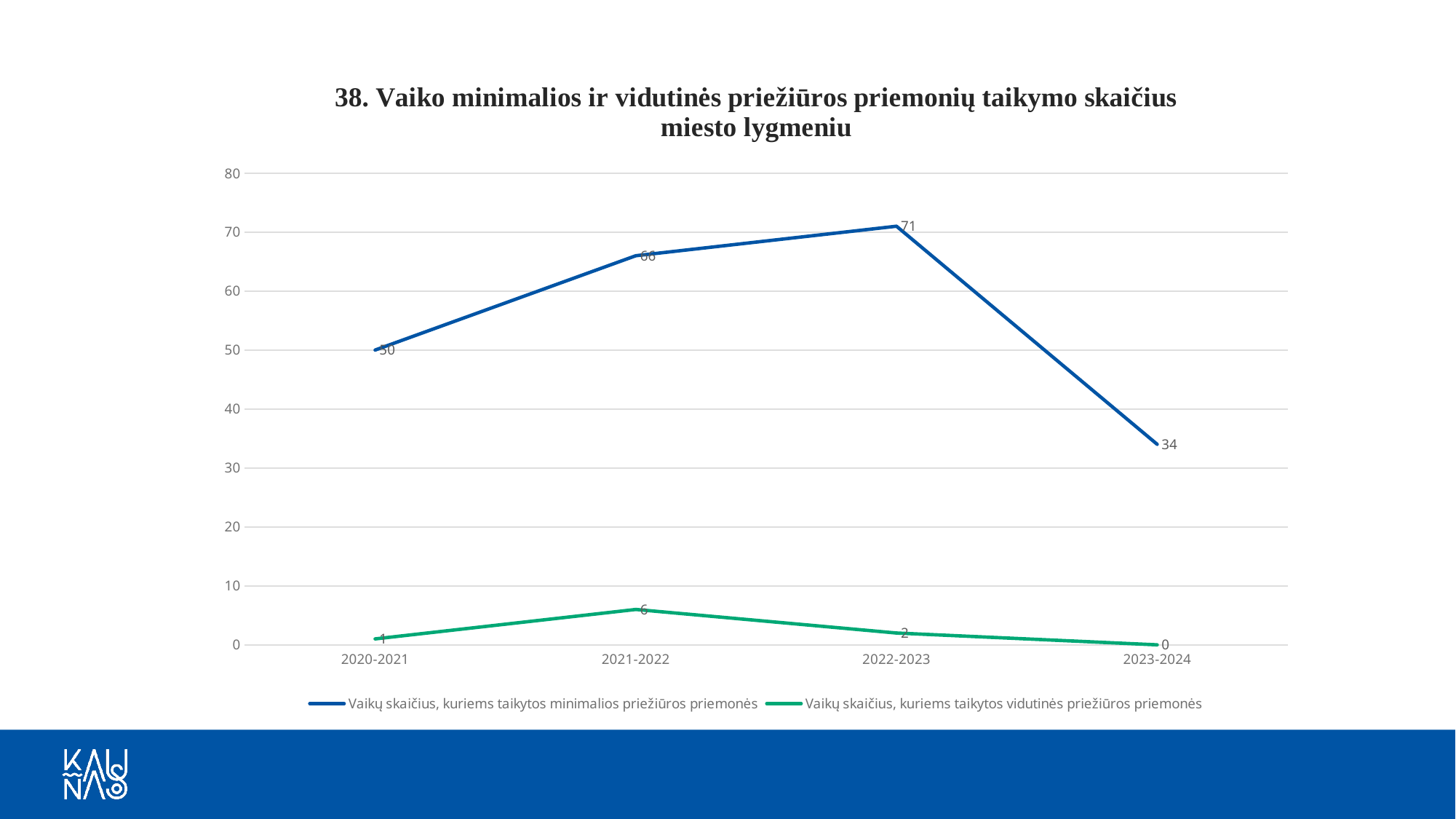
What type of chart is shown on the slide? line chart What is the value for 'Vaikų skaičius, kuriems taikytos minimalios priežiūros priemonės' in 2023-2024? 34 What is the value for 'Vaikų skaičius, kuriems taikytos vidutinės priežiūros priemonės' in 2023-2024? 0 Does the value for 'Vaikų skaičius, kuriems taikytos minimalios priežiūros priemonės' rise or fall from 2022-2023 to 2023-2024? fall In which period is the value for 'Vaikų skaičius, kuriems taikytos minimalios priežiūros priemonės' highest? 2022-2023 What is the value for 'Vaikų skaičius, kuriems taikytos minimalios priežiūros priemonės' in 2022-2023? 71 In which period is the value for 'Vaikų skaičius, kuriems taikytos vidutinės priežiūros priemonės' lowest? 2023-2024 What is the value for 'Vaikų skaičius, kuriems taikytos minimalios priežiūros priemonės' in 2020-2021? 50 What is the difference between the 2022-2023 and 2023-2024 values for 'Vaikų skaičius, kuriems taikytos minimalios priežiūros priemonės'? 37 What is the value for 'Vaikų skaičius, kuriems taikytos vidutinės priežiūros priemonės' in 2021-2022? 6 How many series does the legend list? 2 How many periods are shown on the x axis? 4